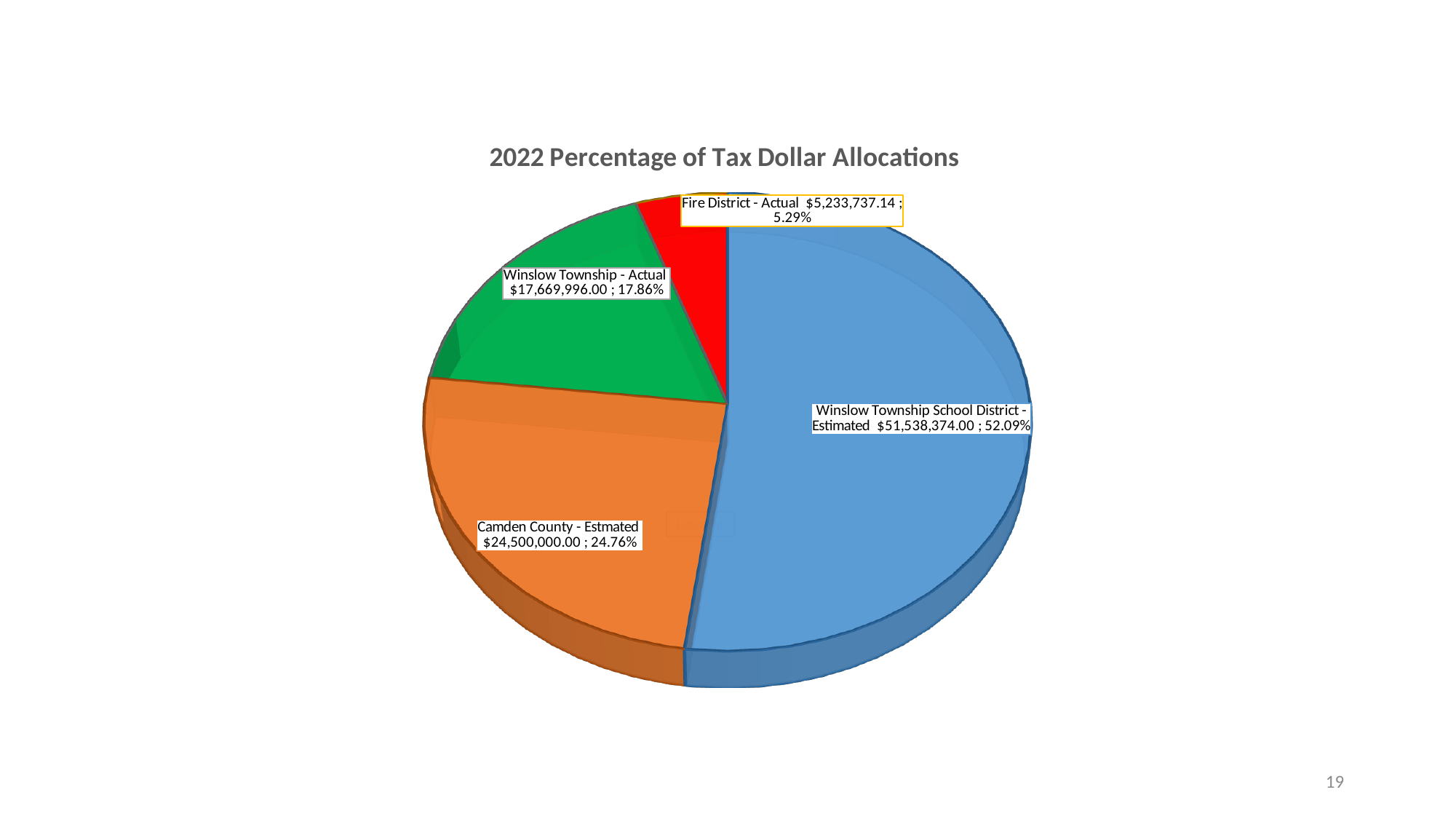
How many slices does the pie chart have? 4 What percentage share of the pie does Winslow Township School District - Estimated represent? 52.09% What is the title of the chart? 2022 Percentage of Tax Dollar Allocations Which is larger, the amount for Camden County - Estmated or the amount for Winslow Township - Actual? Camden County - Estmated What percentage share of the pie does Winslow Township - Actual represent? 17.86% What dollar amount is shown for Fire District - Actual? $5,233,737.14 Which category has the smallest slice of the pie? Fire District - Actual What dollar amount is shown for Winslow Township School District - Estimated? $51,538,374.00 What dollar amount is shown for Camden County - Estmated? $24,500,000.00 What is the difference in percentage points between the Winslow Township School District - Estimated share and the Camden County - Estmated share? 27.33% What kind of chart is shown on the slide? Pie chart Which category has the largest slice of the pie? Winslow Township School District - Estimated